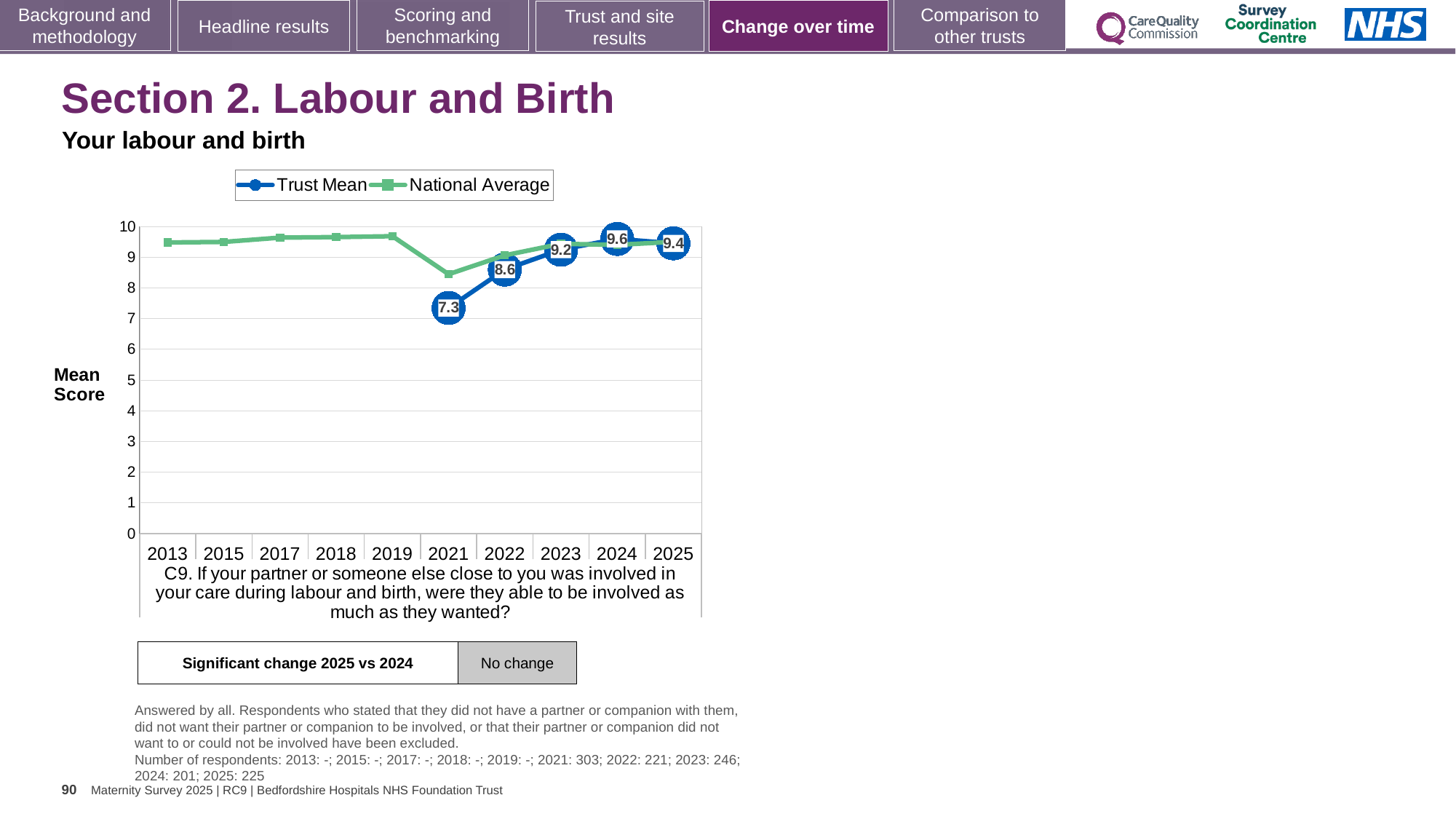
What does the 'Significant change 2025 vs 2024' box below the chart say? No change How many series does the chart legend list? 2 Does the Trust Mean score rise or fall from 2021 to 2024? rise What is the difference between the Trust Mean scores for 2024 and 2021? 2.3 In which year is the Trust Mean score highest? 2024 Is the National Average value for 2021 greater or less than 9? less In which year is the Trust Mean score lowest? 2021 What kind of chart is shown on the slide? line chart What is the Trust Mean score for 2025? 9.4 What is the Trust Mean score for 2021? 7.3 Which year has the larger Trust Mean score, 2022 or 2023? 2023 How many years are shown on the x axis of the chart? 10